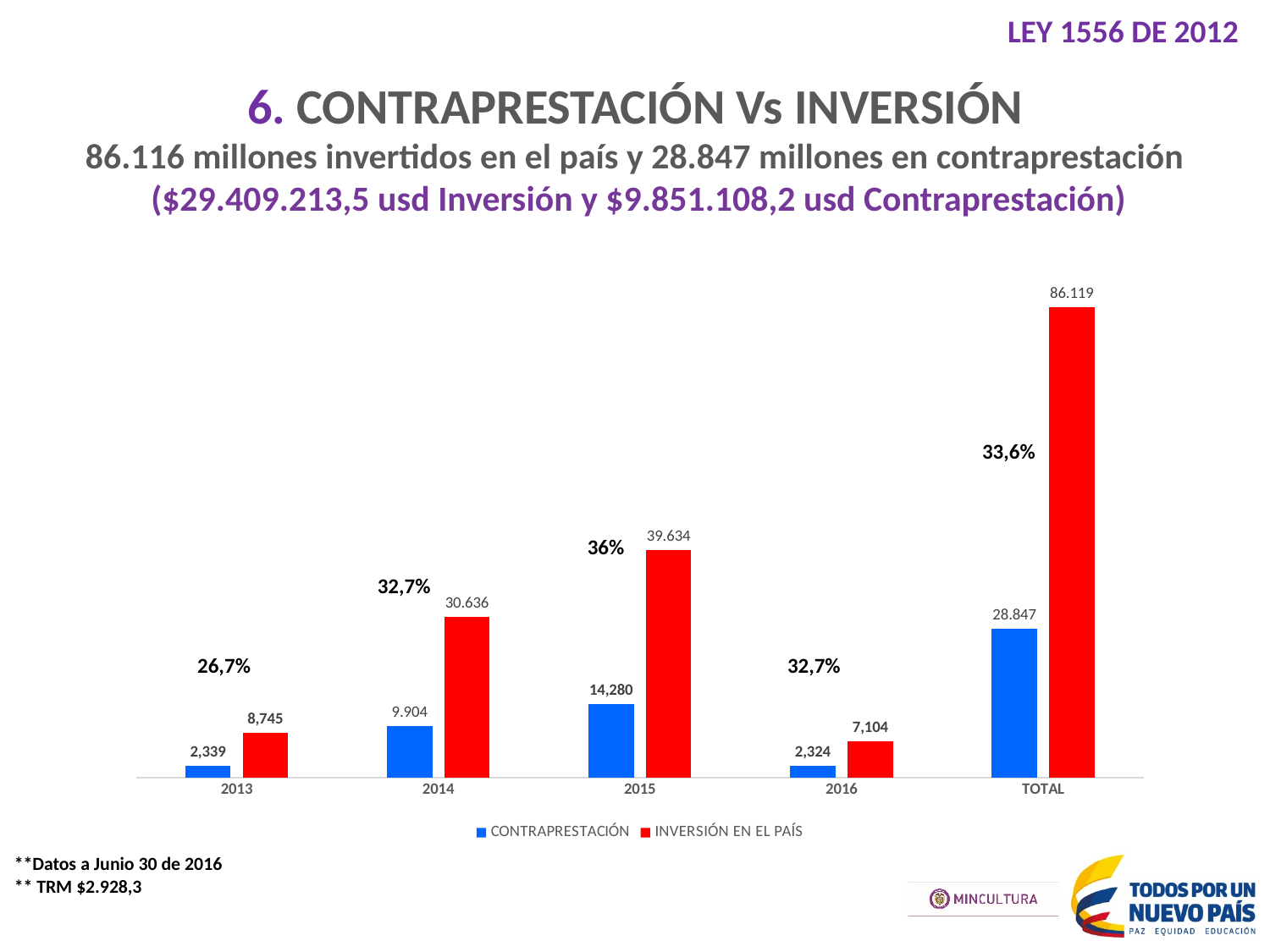
How many series does the legend list? 2 What is the difference between INVERSIÓN EN EL PAÍS and CONTRAPRESTACIÓN for 2013? 6,406 Among the years 2013 to 2016, which year has the highest INVERSIÓN EN EL PAÍS value? 2015 What is the value of CONTRAPRESTACIÓN for 2013? 2,339 What is the value of INVERSIÓN EN EL PAÍS for TOTAL? 86.119 What percentage label is shown above the 2015 bars? 36% What kind of chart is shown on the slide? bar chart What is the value of INVERSIÓN EN EL PAÍS for 2014? 30.636 Which is larger: INVERSIÓN EN EL PAÍS for 2014 or for 2015? 2015 What is the value of CONTRAPRESTACIÓN for 2015? 14,280 How many categories are shown on the x axis? 5 Among the years 2013 to 2016, which year has the lowest INVERSIÓN EN EL PAÍS value? 2016